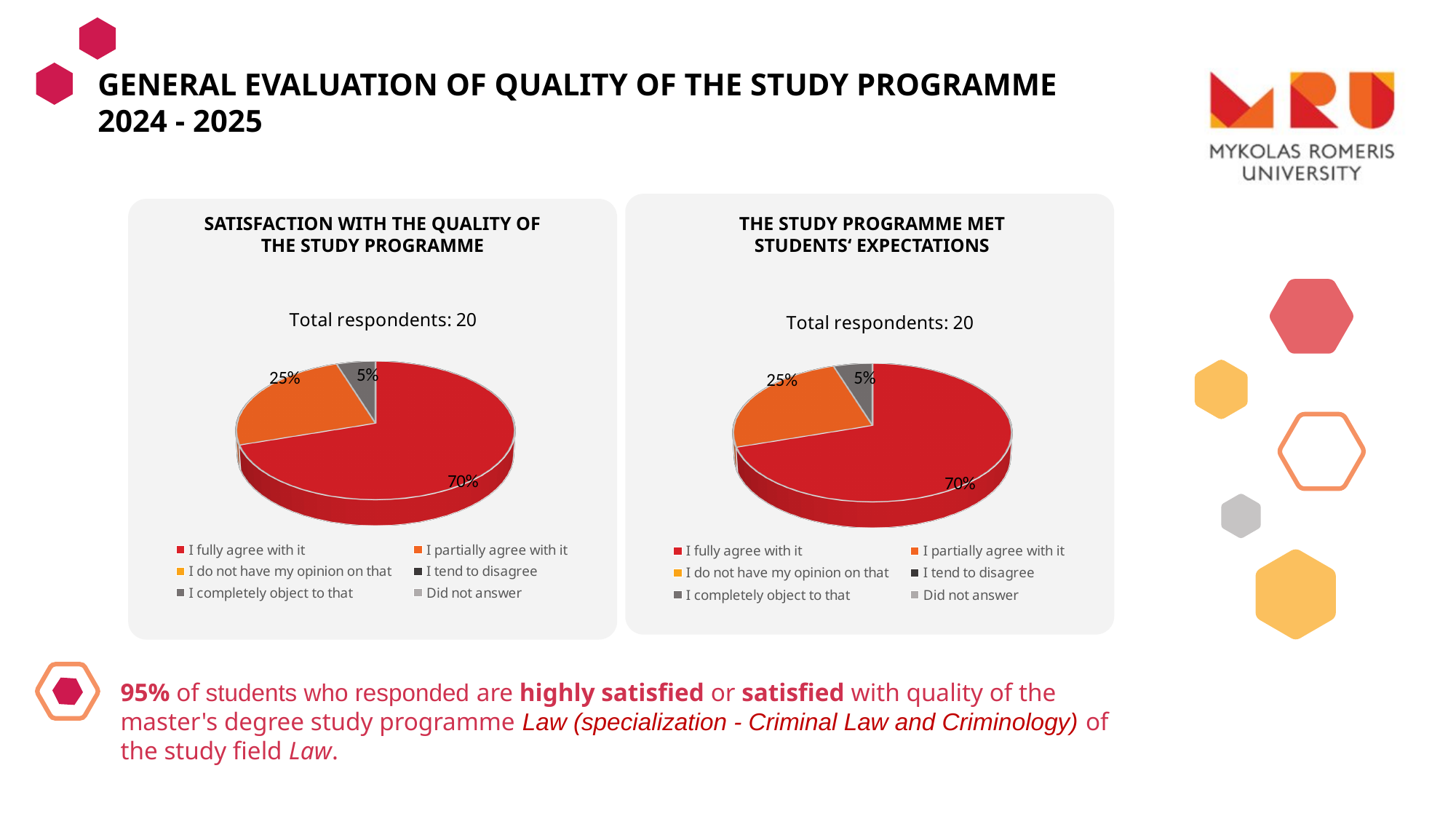
What type of chart is used in the left chart, 'Satisfaction with the quality of the study programme'? Pie chart In the left chart, 'Satisfaction with the quality of the study programme', what share of respondents chose 'I partially agree with it'? 25% How many total respondents are reported for the left chart, 'Satisfaction with the quality of the study programme'? 20 In the right chart, 'The study programme met students' expectations', what share of respondents chose 'I fully agree with it'? 70% In the right chart, 'The study programme met students' expectations', which response has the largest slice? I fully agree with it In the left chart, 'Satisfaction with the quality of the study programme', what share of respondents chose 'I fully agree with it'? 70% How many entries does the legend of the right chart, 'The study programme met students' expectations', list? 6 In the left chart, 'Satisfaction with the quality of the study programme', which response has the largest slice? I fully agree with it In the right chart, 'The study programme met students' expectations', what share of respondents chose 'I partially agree with it'? 25% In the right chart, 'The study programme met students' expectations', which is larger: 'I fully agree with it' or 'I partially agree with it'? I fully agree with it What is the smallest percentage label shown on the right chart, 'The study programme met students' expectations'? 5% In the left chart, 'Satisfaction with the quality of the study programme', what is the difference in percentage points between 'I fully agree with it' and 'I partially agree with it'? 45 percentage points